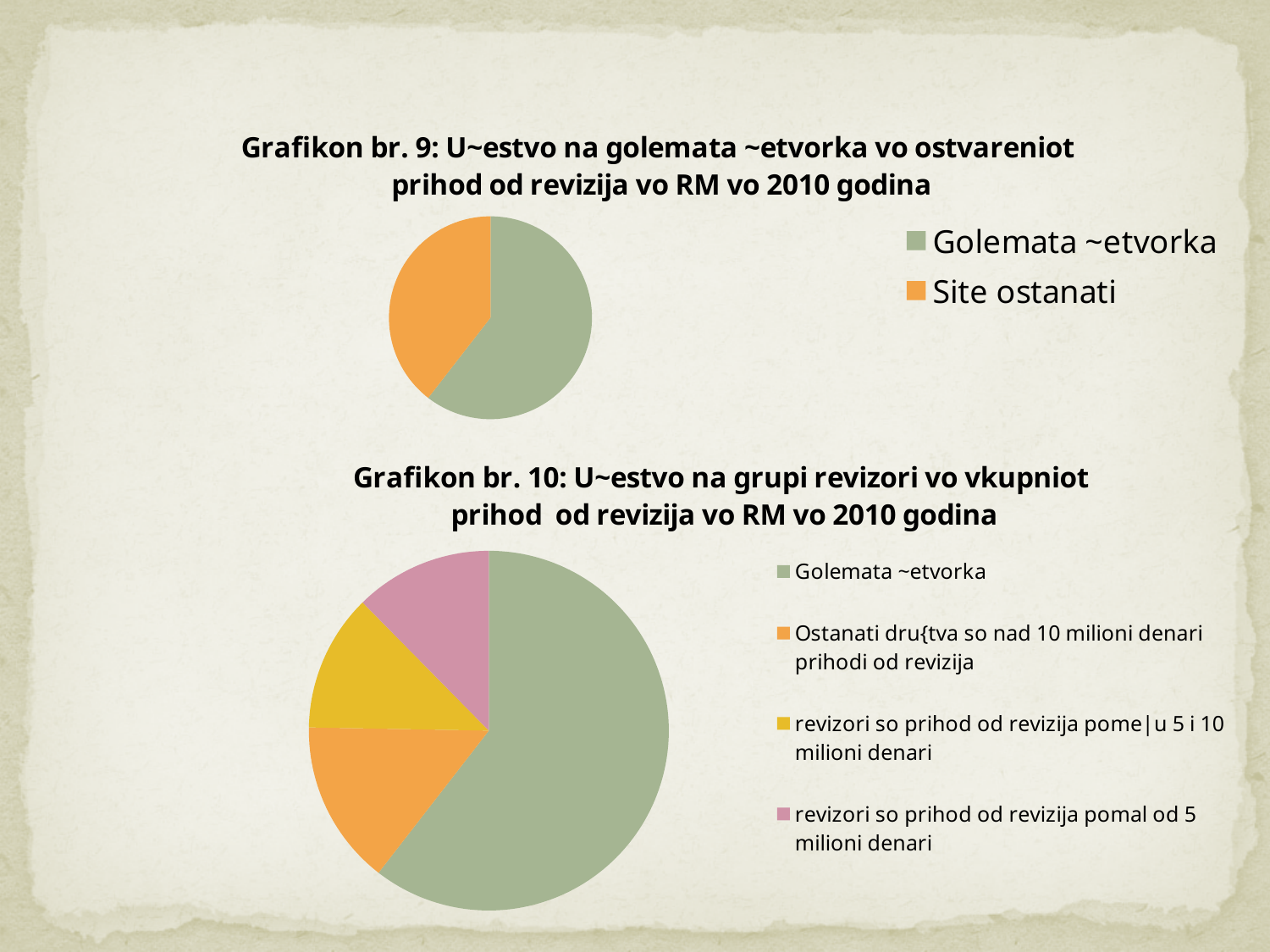
How many entries does the legend of Grafikon br. 9 list? 2 In Grafikon br. 9, which slice is larger: Golemata ~etvorka or Site ostanati? Golemata ~etvorka In Grafikon br. 10, what colour is the slice for Golemata ~etvorka? Green In Grafikon br. 10, which slice is larger: Golemata ~etvorka or Ostanati dru{tva so nad 10 milioni denari prihodi od revizija? Golemata ~etvorka What kind of chart is Grafikon br. 9? Pie chart In Grafikon br. 9, which category has the largest slice? Golemata ~etvorka In Grafikon br. 10, which category has the largest slice? Golemata ~etvorka How many slices does the pie in Grafikon br. 9 have? 2 How many entries does the legend of Grafikon br. 10 list? 4 What kind of chart is Grafikon br. 10? Pie chart How many slices does the pie in Grafikon br. 10 have? 4 In Grafikon br. 9, which category has the smallest slice? Site ostanati